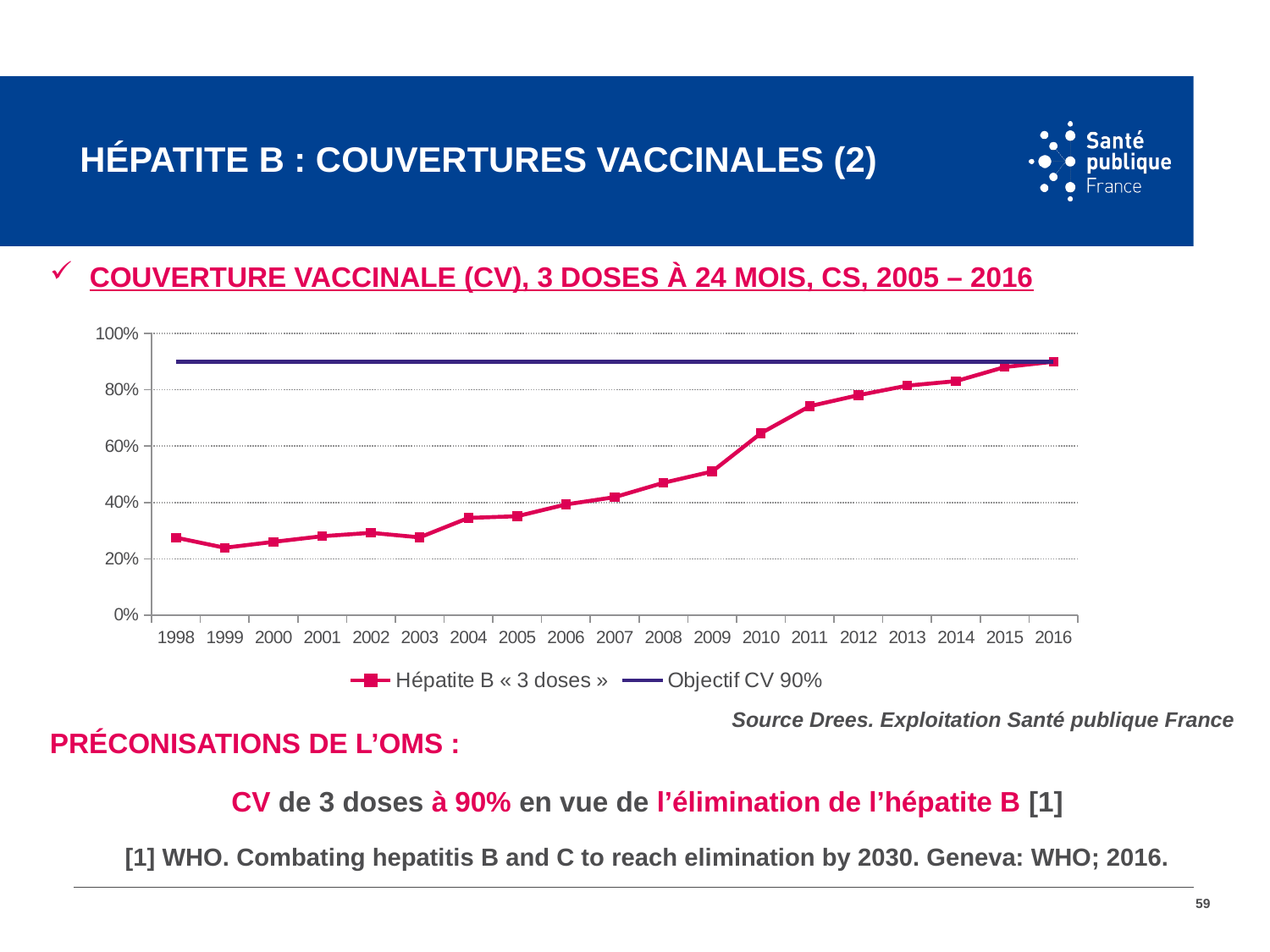
How many years are shown on the x axis of the chart? 19 What is the name of the series drawn with square markers in the chart? Hépatite B « 3 doses » Does the 'Hépatite B « 3 doses »' coverage generally rise or fall from 1998 to 2016? rise What kind of chart is shown on the slide? line chart In which year is the 'Hépatite B « 3 doses »' coverage the highest? 2016 What is the value of the horizontal 'Objectif CV' line in the chart? 90% Is the 'Hépatite B « 3 doses »' value for 1998 greater or less than 40%? less In which year is the 'Hépatite B « 3 doses »' coverage the lowest? 1999 Which is larger, the 'Hépatite B « 3 doses »' value for 2009 or for 2015? 2015 Is the 'Hépatite B « 3 doses »' value for 2010 greater or less than 60%? greater Is the 'Hépatite B « 3 doses »' value for 2011 greater or less than 80%? less How many series does the chart legend list? 2